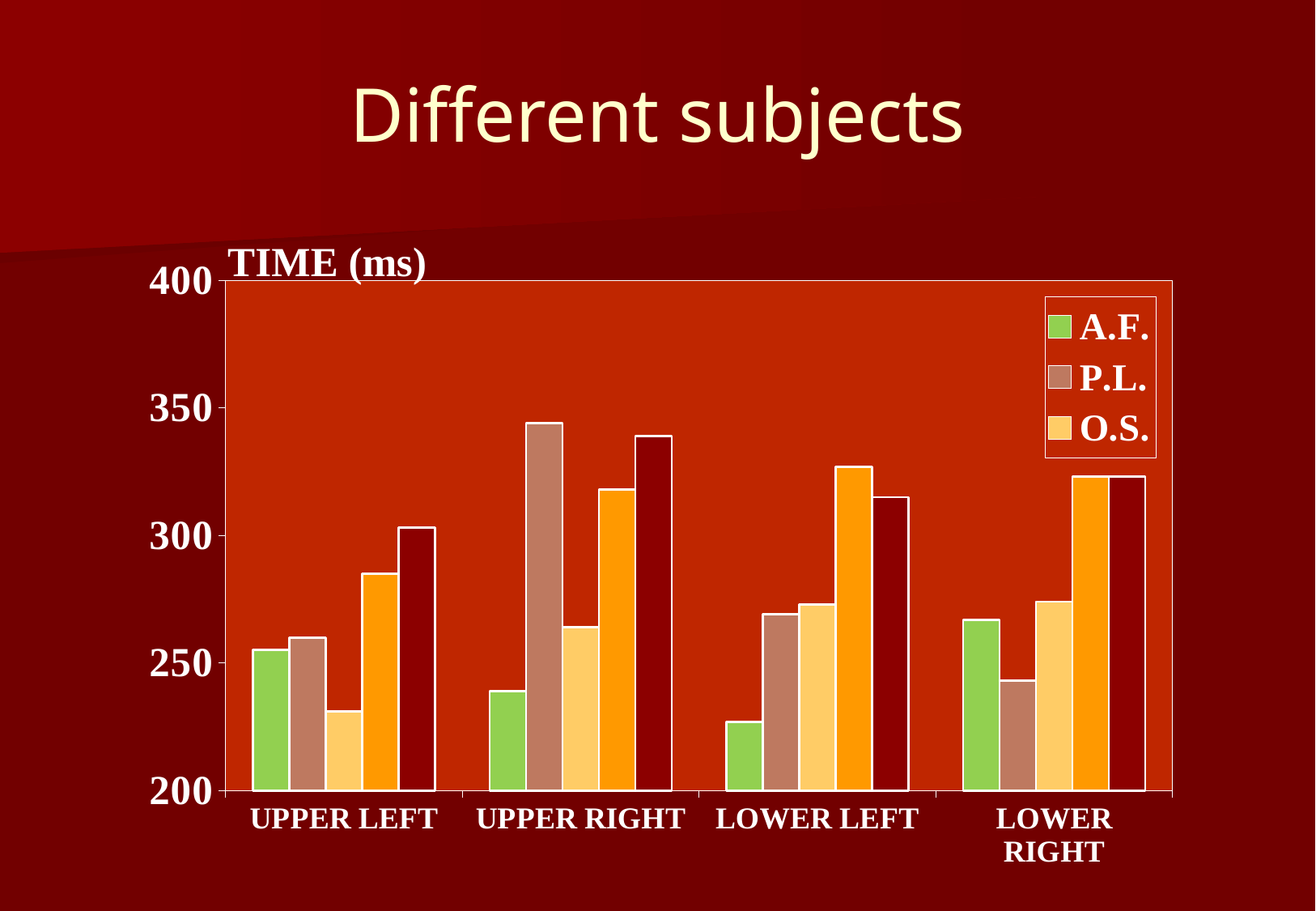
What kind of chart is shown on the slide? bar chart How many series does the chart's legend list? 3 In the UPPER RIGHT category, which is larger: A.F. or P.L.? P.L. Is the value for A.F. in the LOWER LEFT category greater or less than 250? less Is the value for O.S. in the LOWER RIGHT category greater or less than 250? greater How many categories are shown on the x axis of the chart? 4 In which category does P.L. have its highest value? UPPER RIGHT In which category does A.F. have its lowest value? LOWER LEFT Is the value for O.S. in the UPPER LEFT category greater or less than 250? less In the LOWER RIGHT category, which is larger: A.F. or P.L.? A.F. What is the label on the vertical axis of the chart? TIME (ms)